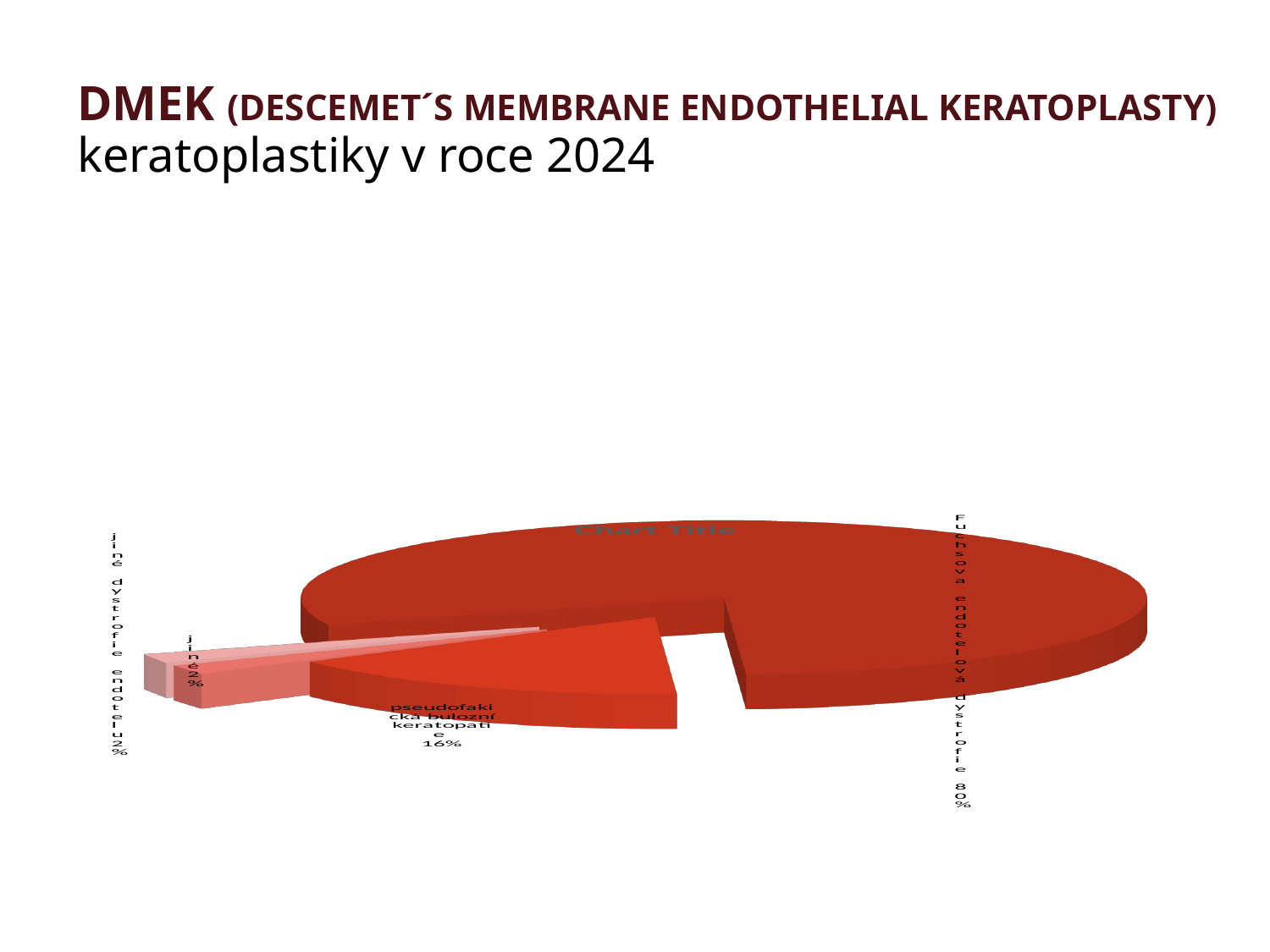
Which slice of the pie is the largest? Fuchsova endotelová dystrofie What share of the pie does jiné dystrofie endotelu have? 2% What is the difference in percentage points between Fuchsova endotelová dystrofie and pseudofakická bulózní keratopatie? 64 What share of the pie does pseudofakická bulózní keratopatie have? 16% What share of the pie does the slice labelled jiné have? 2% What is the title printed on the chart? Chart Title How many slices does the pie chart have? 4 Which is larger, the share for pseudofakická bulózní keratopatie or the share for jiné dystrofie endotelu? pseudofakická bulózní keratopatie What is the combined share of the two slices labelled 2%? 4% What kind of chart is shown on the slide? pie chart